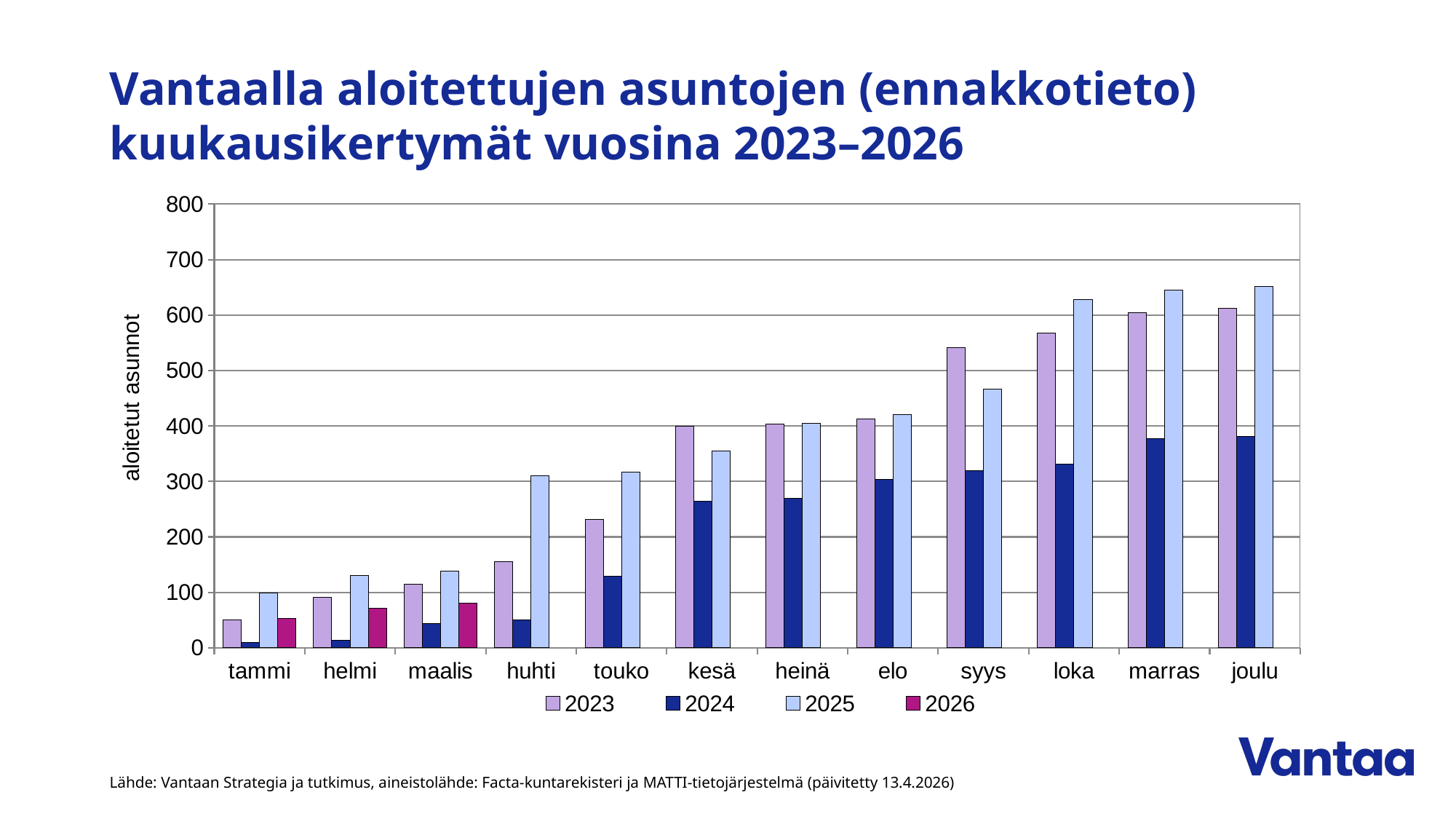
Is the 2024 value for tammi greater or less than 100? less Is the 2025 value for joulu greater or less than 600? greater Is the 2024 value for kesä greater or less than 300? less What kind of chart is shown on the slide? bar chart Which month has the lowest value in the 2023 series? tammi For loka, which series has the larger value, 2023 or 2025? 2025 How many months are shown on the x axis? 12 How many series does the legend list? 4 For syys, which series has the larger value, 2023 or 2025? 2023 For how many months does the 2026 series have a bar? 3 Do the 2025 values generally rise or fall from tammi to joulu? rise